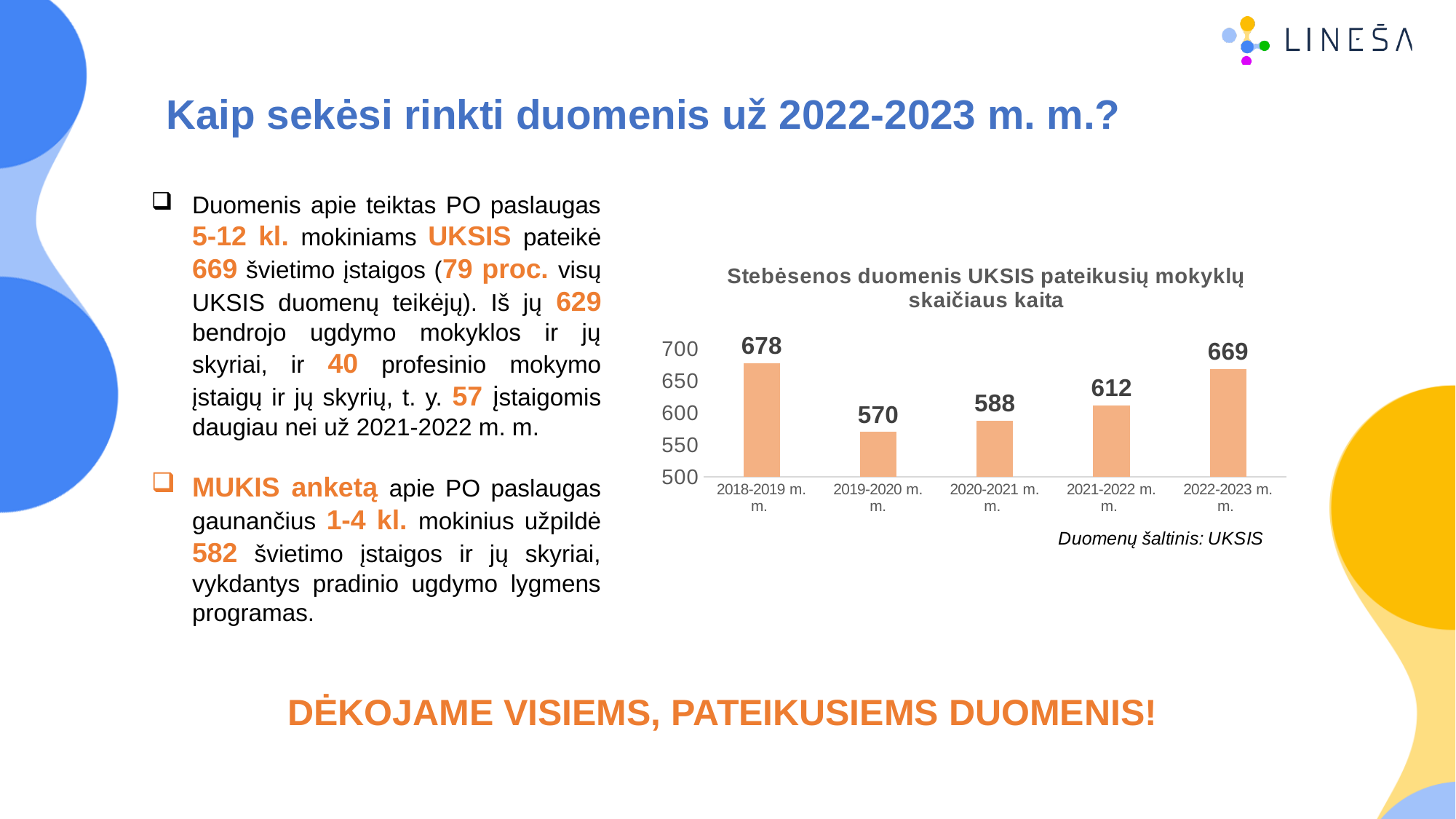
Which school year has the highest value? 2018-2019 m. m. What is the title of the chart? Stebėsenos duomenis UKSIS pateikusių mokyklų skaičiaus kaita What kind of chart is shown on the slide? bar chart What is the difference between the values for 2018-2019 m. m. and 2019-2020 m. m.? 108 What is the value for 2019-2020 m. m.? 570 What is the value for 2022-2023 m. m.? 669 What is the difference between the values for 2022-2023 m. m. and 2021-2022 m. m.? 57 Is the value for 2020-2021 m. m. greater or less than 600? less Which is larger, the value for 2020-2021 m. m. or 2021-2022 m. m.? 2021-2022 m. m. Which school year has the lowest value? 2019-2020 m. m. How many school years are shown on the chart? 5 What is the value for 2018-2019 m. m.? 678